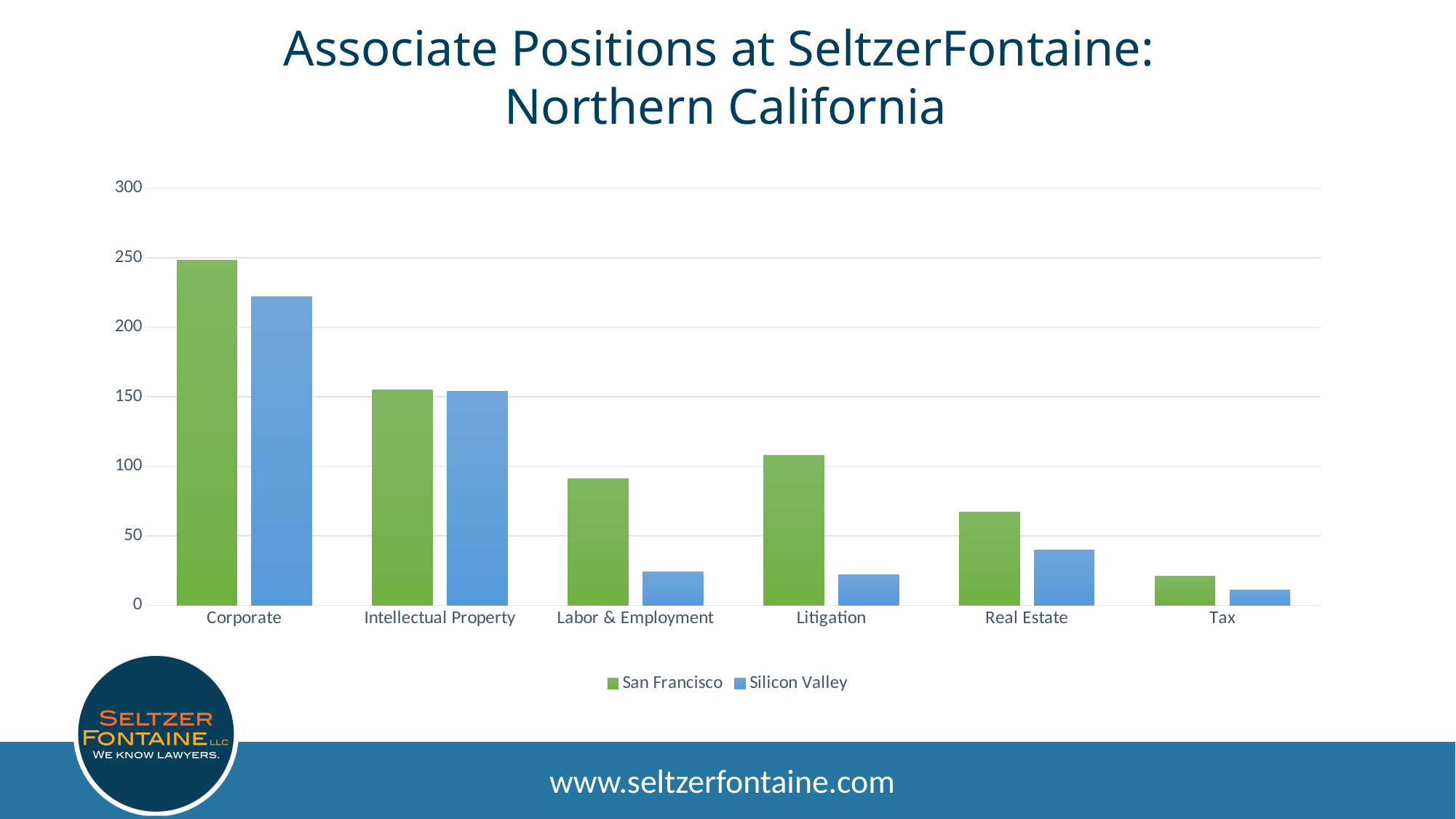
Which practice area has the highest San Francisco value? Corporate How many series does the legend list? 2 Which colour represents San Francisco in the legend? green For Labor & Employment, which is larger: the San Francisco value or the Silicon Valley value? San Francisco Is the Silicon Valley value for Real Estate greater or less than 50? less Is the San Francisco value for Corporate greater or less than 200? greater Which practice area has the lowest Silicon Valley value? Tax Which practice area has the highest Silicon Valley value? Corporate Is the Silicon Valley value for Labor & Employment greater or less than 50? less How many practice-area categories are shown on the x axis? 6 Which practice area has the lowest San Francisco value? Tax What kind of chart is shown on the slide? bar chart